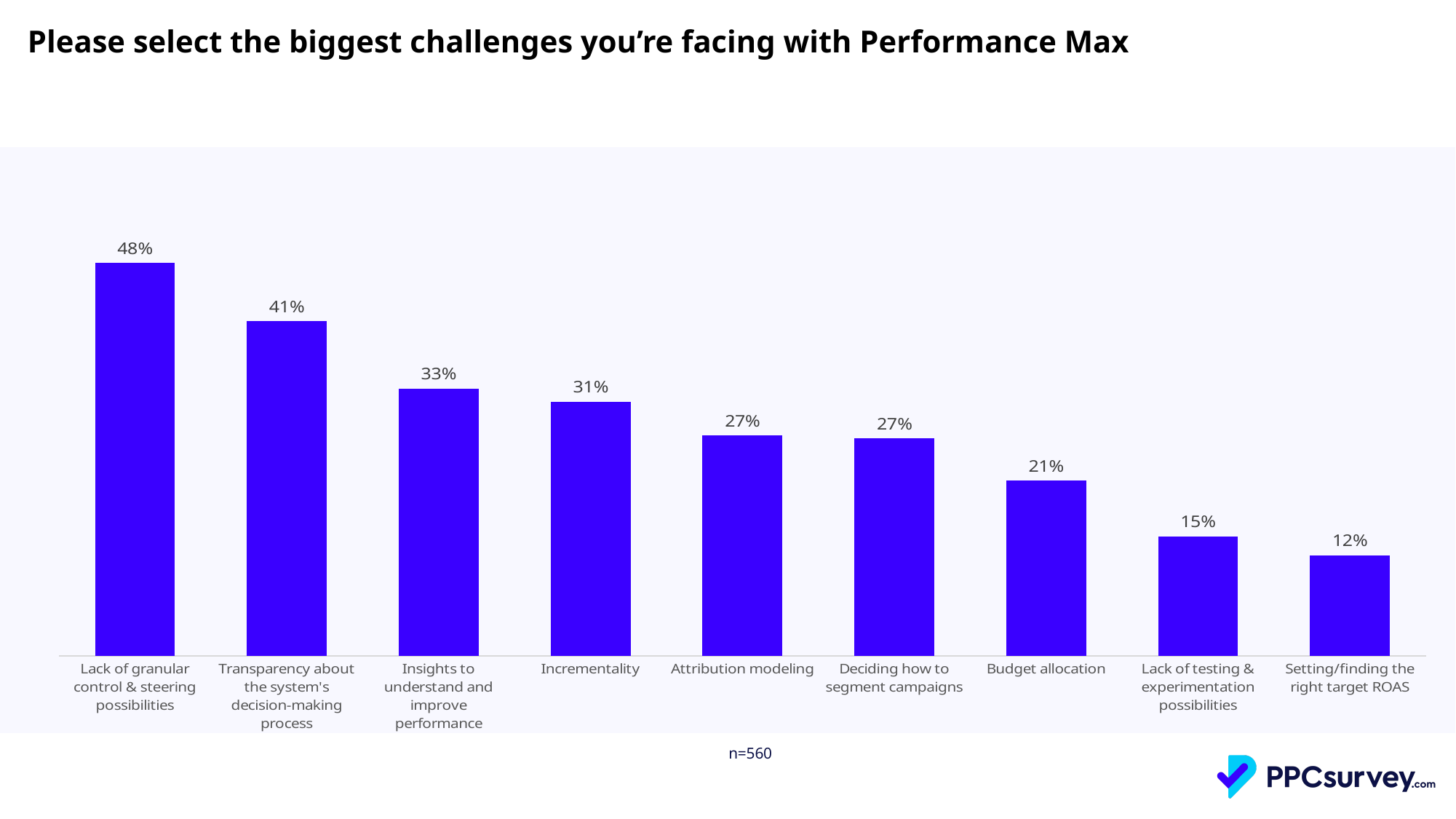
What is the sample size (n) shown below the chart? n=560 What is the value shown for 'Incrementality'? 31% What percentage is shown for 'Budget allocation'? 21% What is the value for 'Setting/finding the right target ROAS'? 12% What type of chart is shown on the slide? Bar chart What is the difference in percentage points between 'Transparency about the system's decision-making process' and 'Insights to understand and improve performance'? 8 percentage points Do the values rise or fall moving from left to right across the chart? Fall How many challenge categories are shown in the chart? 9 Which challenge has the highest percentage? Lack of granular control & steering possibilities Which is larger: the value for 'Attribution modeling' or the value for 'Lack of testing & experimentation possibilities'? Attribution modeling What percentage of respondents selected 'Lack of granular control & steering possibilities' as a challenge? 48% Which challenge has the lowest percentage? Setting/finding the right target ROAS